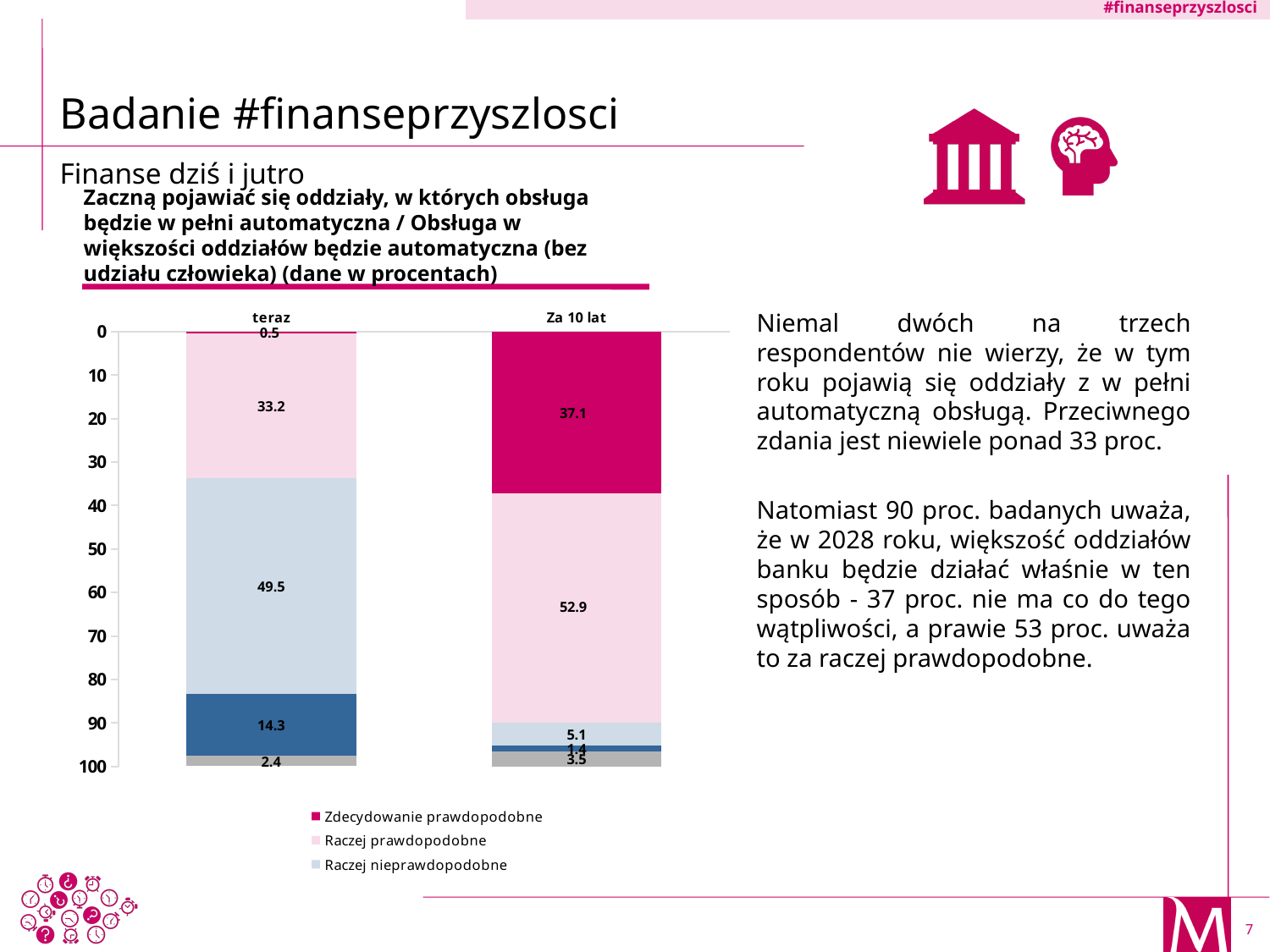
What is the difference between the "Zdecydowanie prawdopodobne" values for "Za 10 lat" and "teraz"? 36.6 What is the value for "Raczej nieprawdopodobne" in the "teraz" bar? 49.5 Which bar has the larger value for "Raczej prawdopodobne", "teraz" or "Za 10 lat"? Za 10 lat What kind of chart is shown on the slide? Stacked bar chart How many series does the legend list? 3 How many bars (categories) does the chart show? 2 What is the value for "Raczej nieprawdopodobne" in the "Za 10 lat" bar? 5.1 What is the value for "Zdecydowanie prawdopodobne" in the "Za 10 lat" bar? 37.1 Which series has the largest segment in the "Za 10 lat" bar? Raczej prawdopodobne What is the value for "Raczej prawdopodobne" in the "teraz" bar? 33.2 What is the total of all segments in the "teraz" bar? 99.9 Which series has the largest segment in the "teraz" bar? Raczej nieprawdopodobne